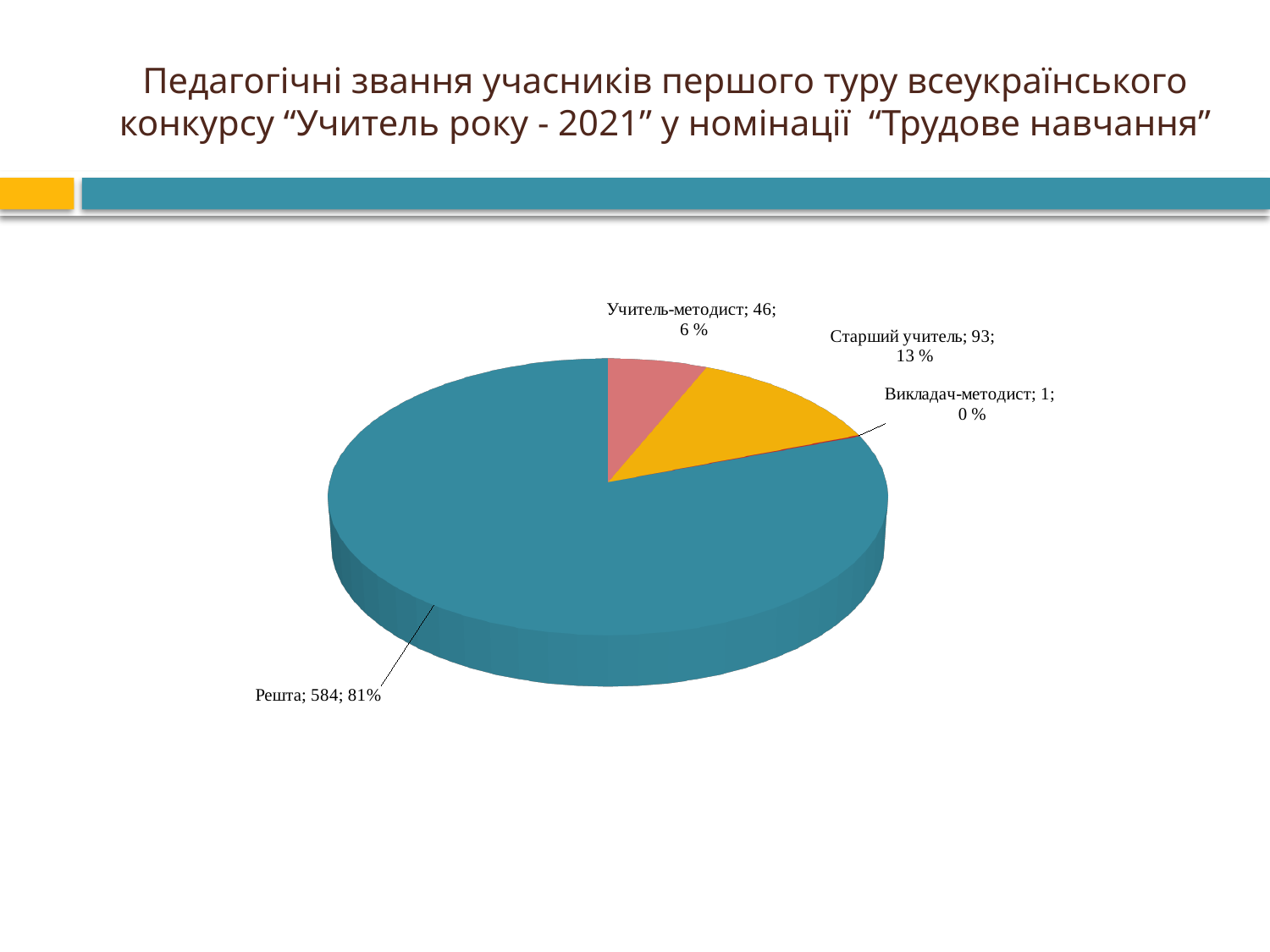
How many slices does the pie chart have? 4 Which is larger, the value for Учитель-методист or the value for Старший учитель? Старший учитель Which category has the largest slice? Решта What kind of chart is shown on the slide? Pie chart What is the value for Решта? 584 Which category has the smallest slice? Викладач-методист What is the difference between the values for Старший учитель and Учитель-методист? 47 What is the value for Учитель-методист? 46 What share of the pie does Старший учитель represent? 13 % What is the value for Викладач-методист? 1 What is the value for Старший учитель? 93 What share of the pie does Решта represent? 81%